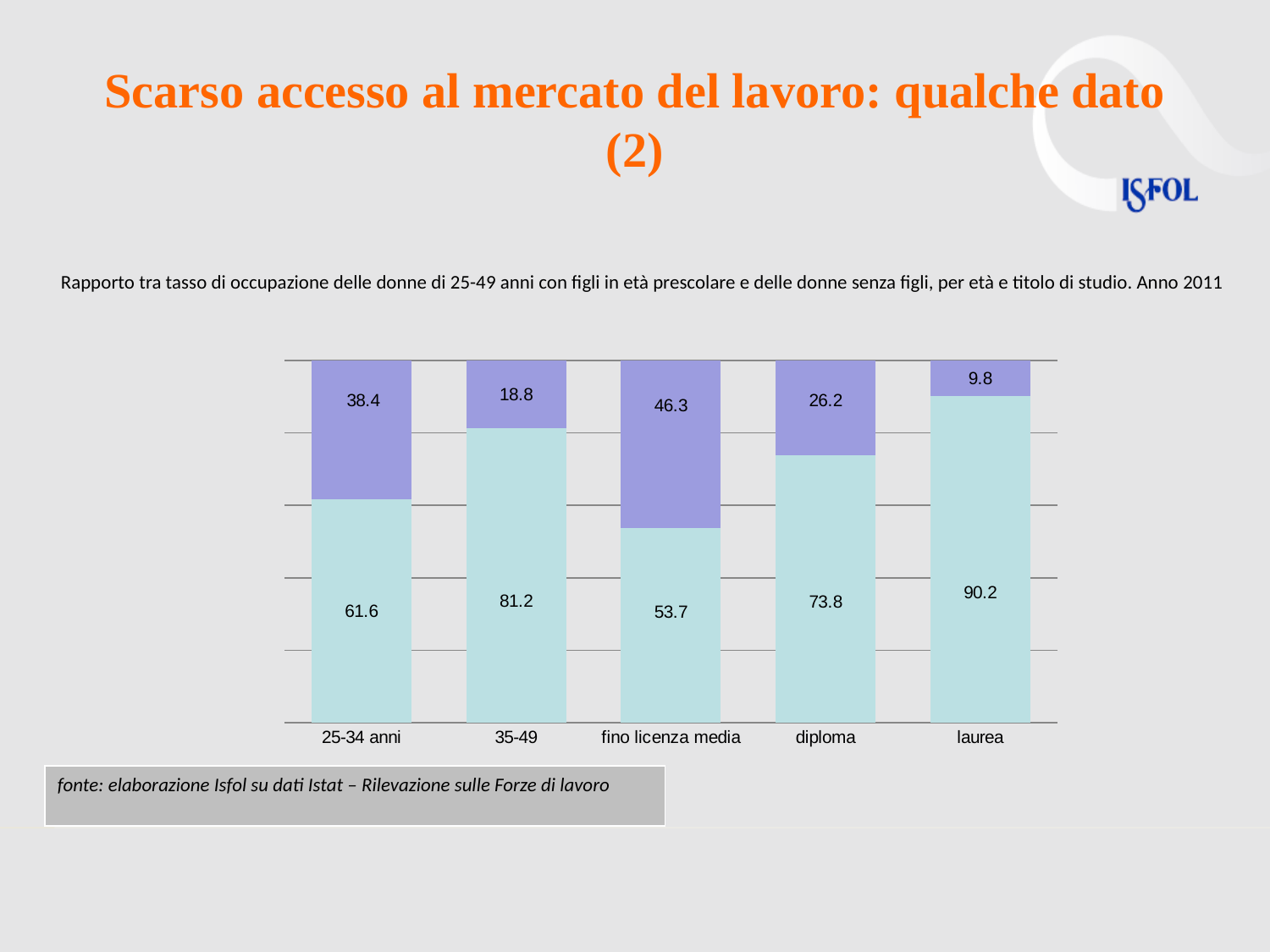
How many categories are shown on the x axis? 5 Which category has the lowest light blue segment value? fino licenza media What is the difference between the light blue segment values for 'diploma' and 'fino licenza media'? 20.1 What kind of chart is shown on the slide? stacked bar chart What is the total of the stacked bar for '25-34 anni'? 100 Which is larger: the purple segment for 'diploma' or the purple segment for '35-49'? diploma What is the value of the light blue segment for 'laurea'? 90.2 What is the value of the purple segment for 'fino licenza media'? 46.3 Which category has the highest light blue segment value? laurea What is the value of the light blue segment for '35-49'? 81.2 Which category has the lowest purple segment value? laurea What is the value of the purple segment for '25-34 anni'? 38.4